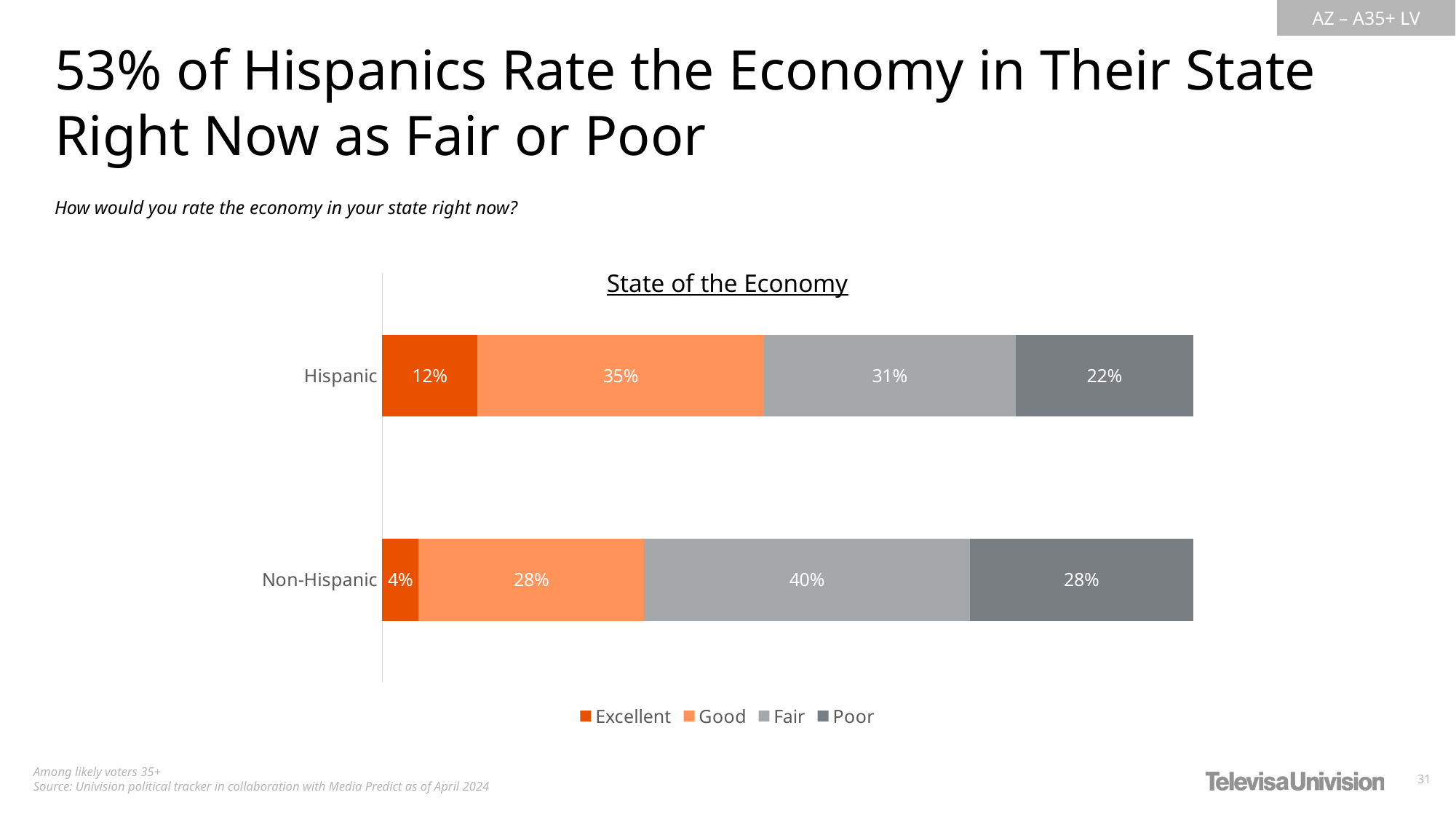
What kind of chart is shown on the slide? Stacked bar chart What is the combined share of Hispanic respondents rating the economy as Fair or Poor? 53% Which rating category has the largest share among Hispanic respondents? Good What is the title of the chart? State of the Economy Which rating category has the smallest share among Non-Hispanic respondents? Excellent How many series does the legend list? 4 What percentage of Hispanic respondents rate the economy in their state as Excellent? 12% What is the difference between the Fair share for Non-Hispanic respondents and the Fair share for Hispanic respondents? 9% What percentage of Non-Hispanic respondents rate the economy in their state as Fair? 40% What percentage of Hispanic respondents rate the economy as Poor? 22% Which group has a larger share rating the economy as Poor, Hispanic or Non-Hispanic? Non-Hispanic What percentage of Non-Hispanic respondents rate the economy as Good? 28%